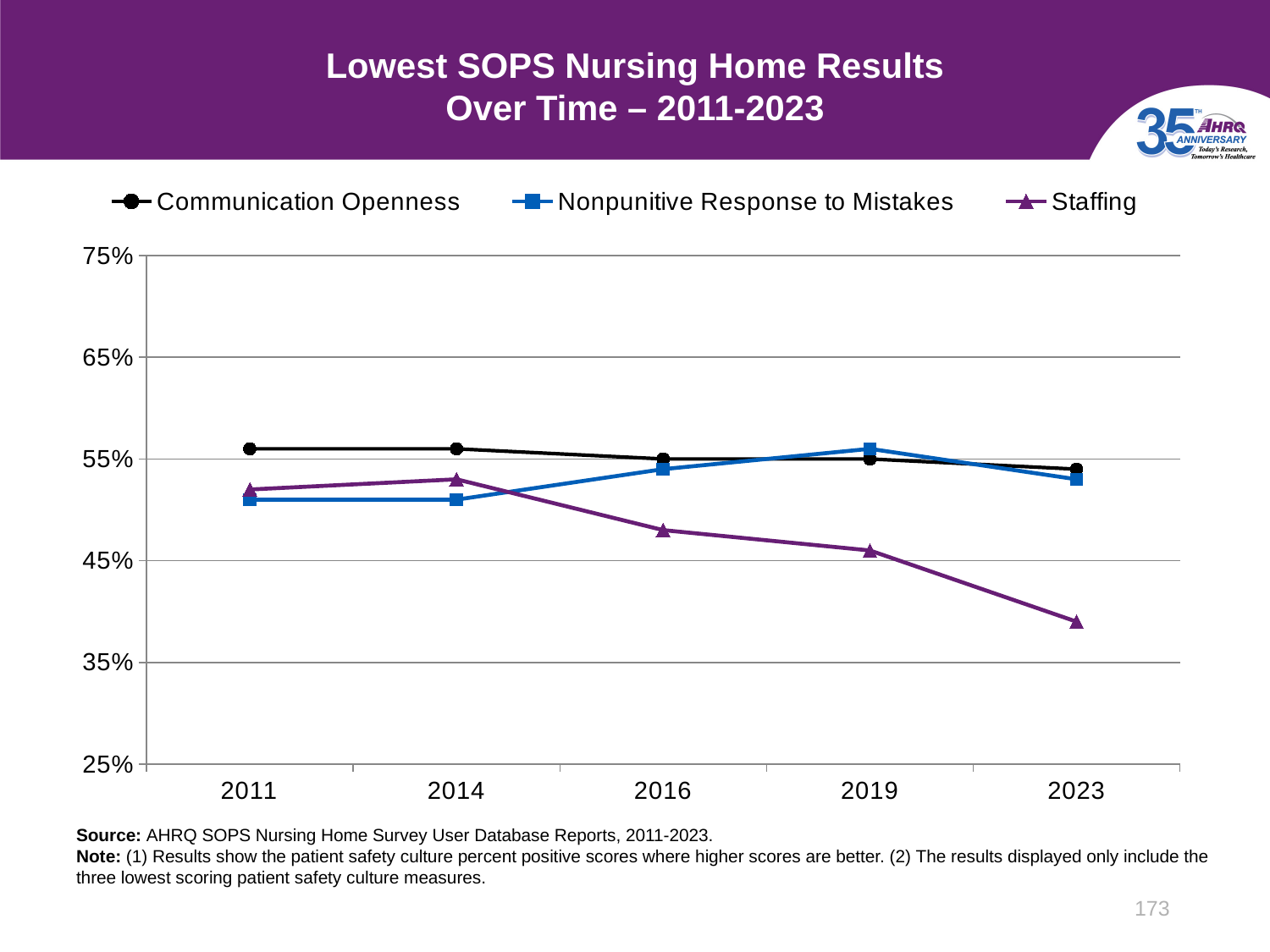
In 2023, which is larger: Communication Openness or Staffing? Communication Openness How many series does the legend list? 3 Does the Staffing series rise or fall from 2011 to 2023? fall In 2019, which is larger: Staffing or Nonpunitive Response to Mistakes? Nonpunitive Response to Mistakes How many years are plotted along the x axis? 5 Is the value for Communication Openness in 2014 greater or less than 45%? greater What kind of chart is shown on the slide? line chart Is the value for Staffing in 2023 greater or less than 45%? less Is the value for Nonpunitive Response to Mistakes in 2011 greater or less than 55%? less What is the title of the chart? Lowest SOPS Nursing Home Results Over Time – 2011-2023 Which series has the highest value in 2011? Communication Openness Which series has the lowest value in 2023? Staffing